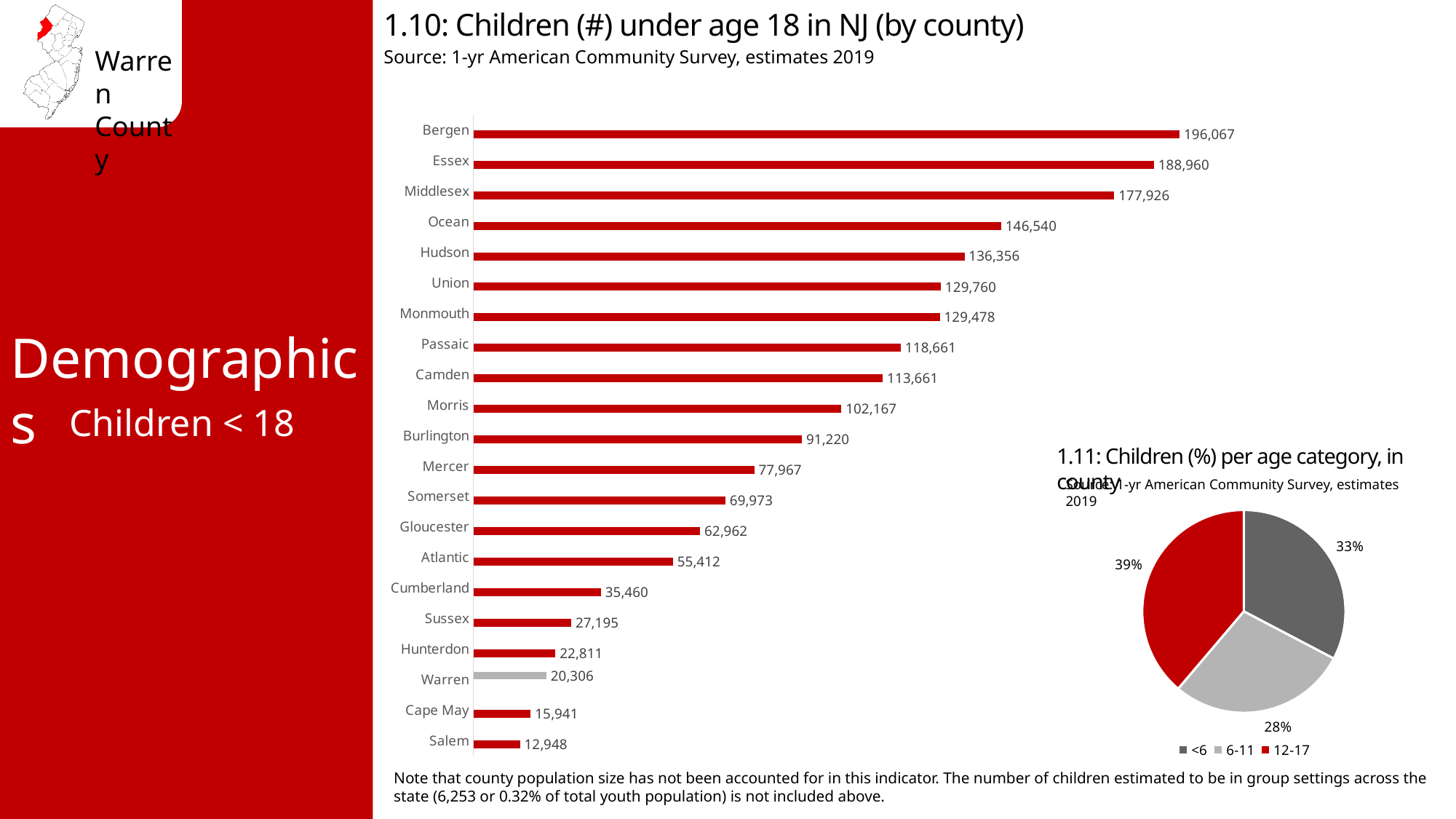
In the chart '1.10: Children (#) under age 18 in NJ (by county)', which bar is coloured differently (grey) from the others? Warren How many counties are shown in the chart '1.10: Children (#) under age 18 in NJ (by county)'? 21 In the chart '1.10: Children (#) under age 18 in NJ (by county)', which county has the lowest value? Salem What kind of chart is '1.10: Children (#) under age 18 in NJ (by county)'? Bar chart In the chart '1.11: Children (%) per age category, in county', what share is the 6-11 age category? 28% How many categories does the legend of the chart '1.11: Children (%) per age category, in county' list? 3 In the chart '1.10: Children (#) under age 18 in NJ (by county)', what is the value for Warren? 20,306 In the chart '1.10: Children (#) under age 18 in NJ (by county)', which county has the highest value? Bergen In the chart '1.10: Children (#) under age 18 in NJ (by county)', which is larger, the value for Ocean or the value for Hudson? Ocean In the chart '1.10: Children (#) under age 18 in NJ (by county)', what is the value for Hudson? 136,356 In the chart '1.11: Children (%) per age category, in county', which age category has the largest share? 12-17 In the chart '1.10: Children (#) under age 18 in NJ (by county)', what is the difference between the values for Bergen and Essex? 7,107